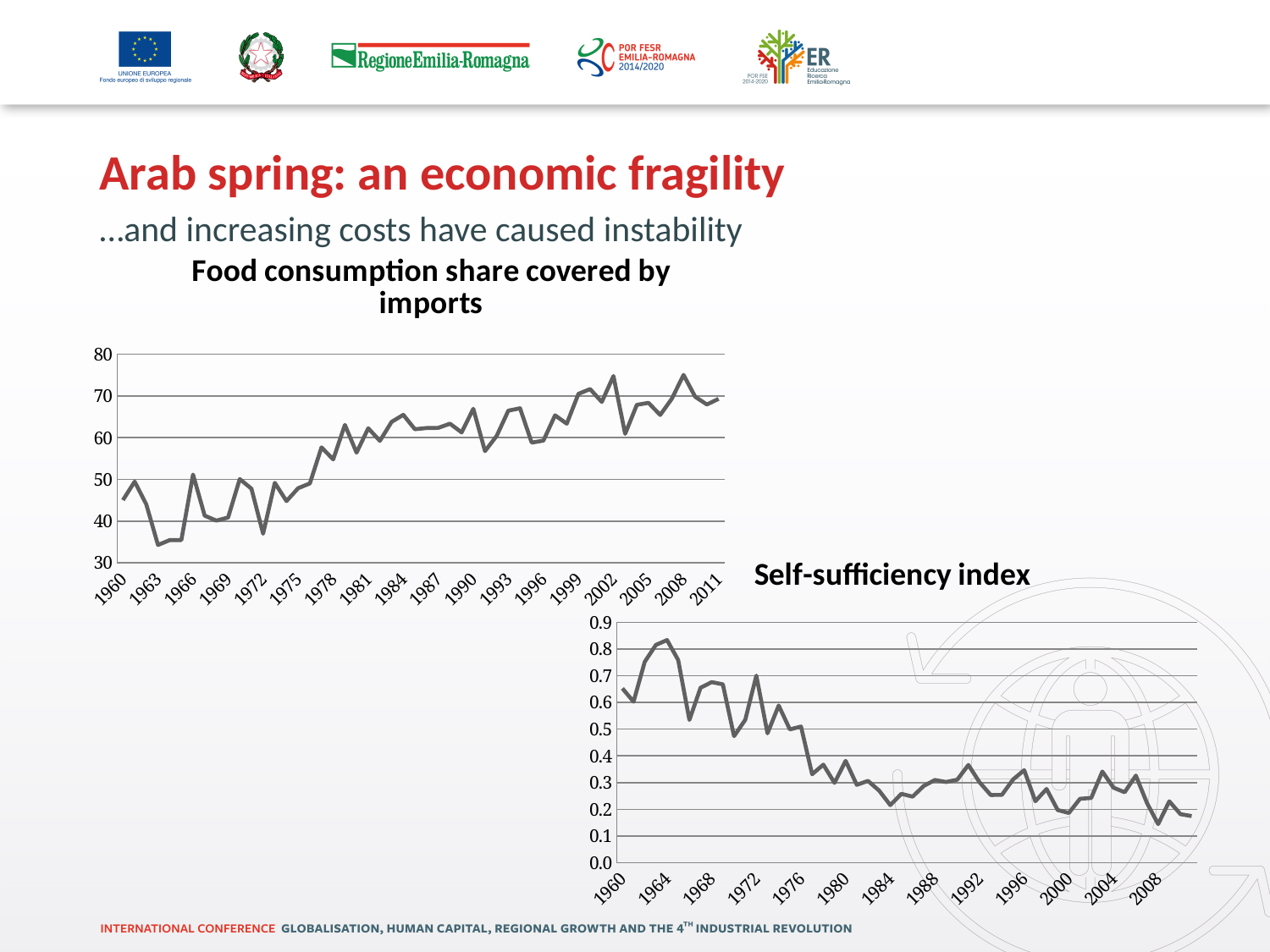
In the 'Self-sufficiency index' chart, is the value for 1960 larger or smaller than the value for 2008? larger What is the title of the upper-left chart on the slide? Food consumption share covered by imports In the 'Self-sufficiency index' chart, which year has the highest value? 1964 In the 'Self-sufficiency index' chart, is the value for 1984 greater or less than 0.3? less In the 'Food consumption share covered by imports' chart, is the value for 2002 greater or less than 70? greater In the 'Food consumption share covered by imports' chart, do the values generally rise or fall from 1960 to 2011? rise What kind of chart is the 'Self-sufficiency index' chart? line chart In the 'Self-sufficiency index' chart, is the value for 1964 greater or less than 0.8? greater In the 'Self-sufficiency index' chart, do the values generally rise or fall from 1960 to 2008? fall What kind of chart is the 'Food consumption share covered by imports' chart? line chart